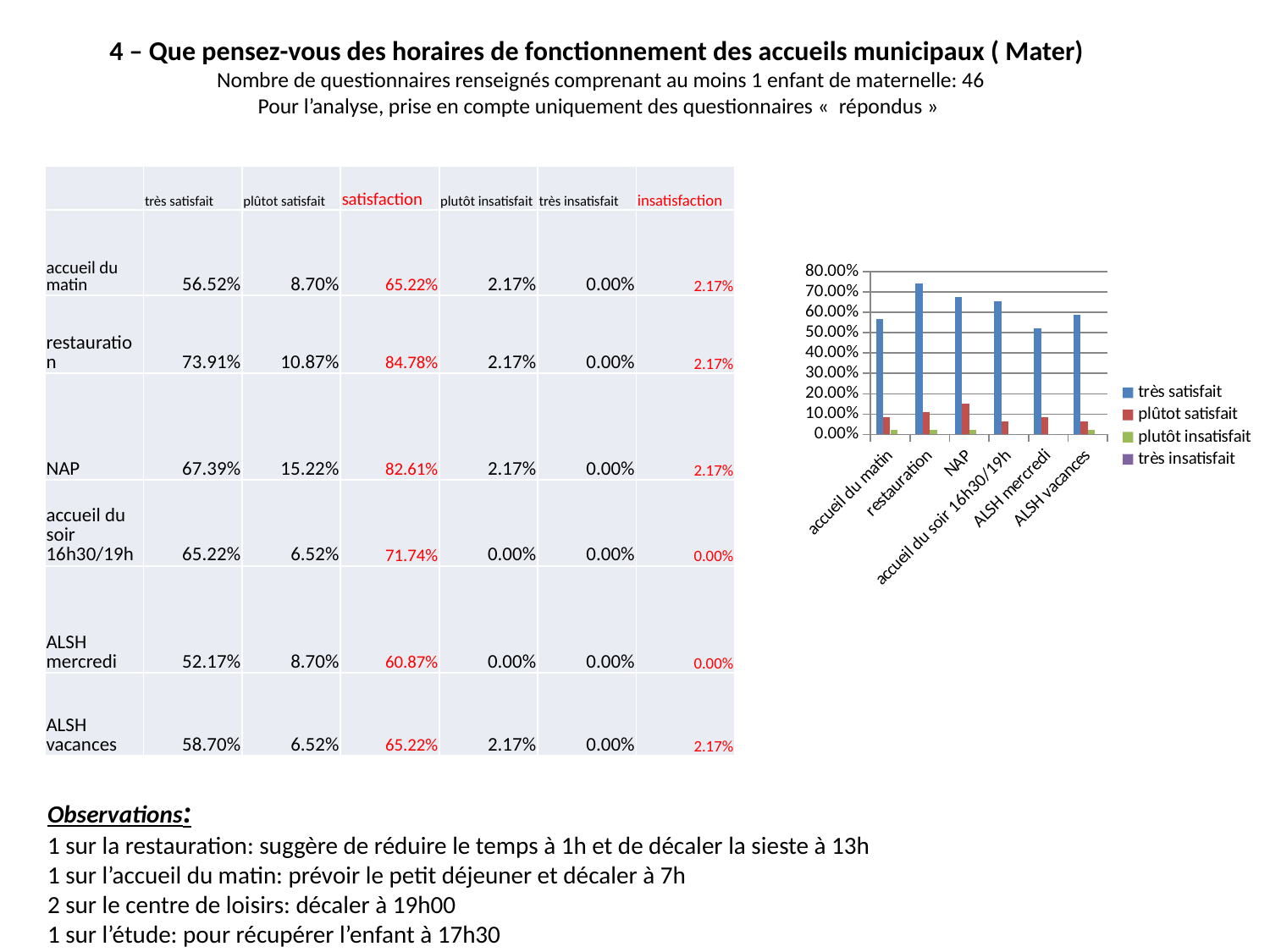
What is the highest value shown on the chart's y axis? 80.00% How many categories are shown on the x axis of the chart? 6 Which category has the highest 'très satisfait' bar in the chart? restauration What is the 'très satisfait' value for NAP? 67.39% Is the 'très satisfait' value for ALSH mercredi greater or less than 60.00%? less Is the 'très satisfait' value for restauration greater or less than 70.00%? greater How many series does the chart legend list? 4 Which is larger: the 'très satisfait' value for restauration or for ALSH mercredi? restauration What kind of chart is shown on the slide? bar chart What is the difference between the 'très satisfait' values for restauration and ALSH mercredi? 21.74% Which category has the highest 'plûtot satisfait' bar in the chart? NAP Which category has the lowest 'très satisfait' bar in the chart? ALSH mercredi